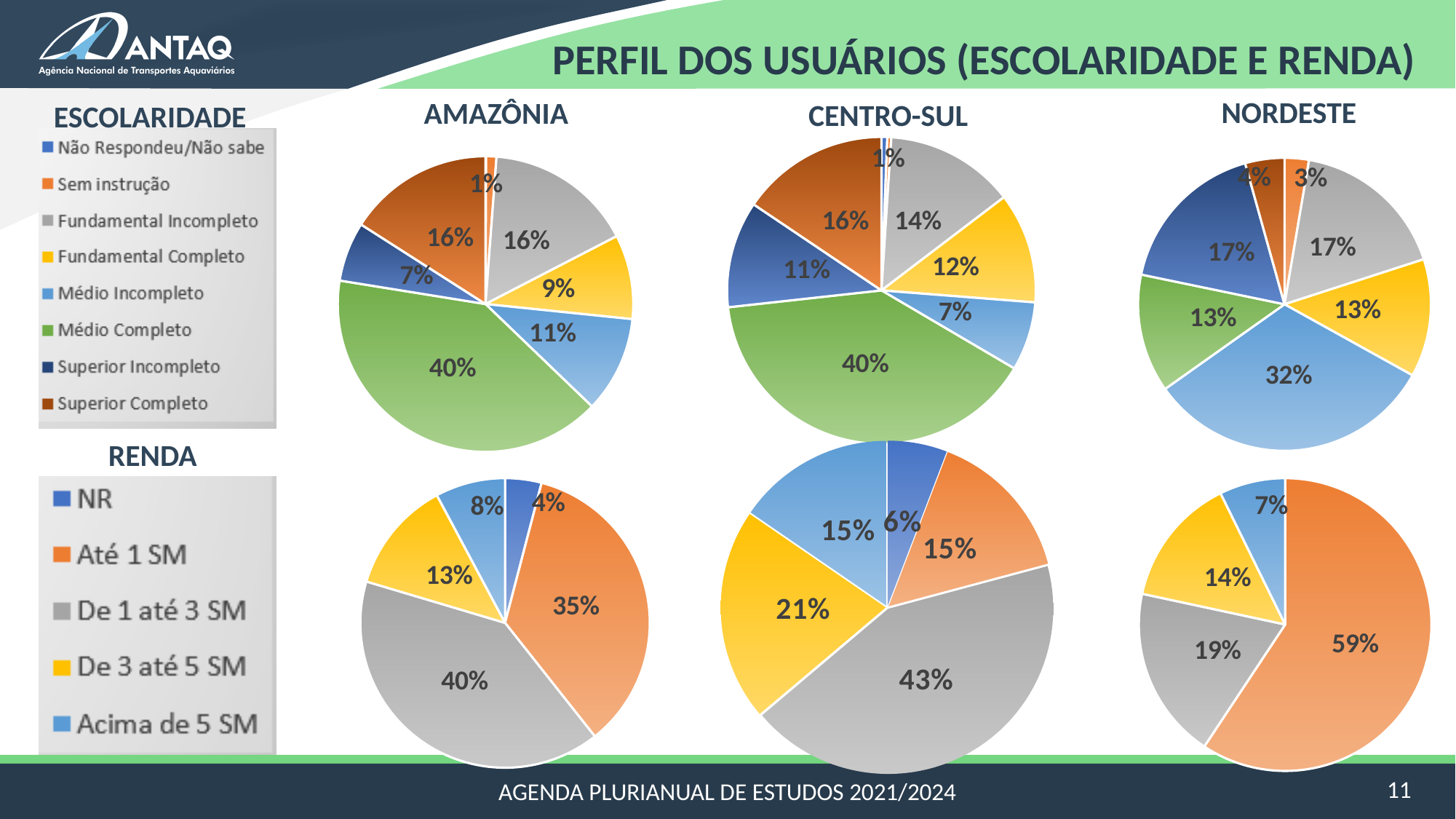
In the Nordeste Renda pie chart, what is the difference between De 1 até 3 SM and De 3 até 5 SM? 5% In the Amazônia Escolaridade pie chart, what share is Médio Completo? 40% In the Nordeste Escolaridade pie chart, what share is Médio Incompleto? 32% In the Amazônia Renda pie chart, which category has the smallest share? NR What type of chart is used for the Amazônia Renda data? Pie chart In the Centro-Sul Renda pie chart, which category has the largest share? De 1 até 3 SM How many categories does the Escolaridade legend list? 8 In the Nordeste Renda pie chart, what share is Até 1 SM? 59% In the Amazônia Renda pie chart, what is the difference between De 1 até 3 SM and Até 1 SM? 5% In the Centro-Sul Escolaridade pie chart, which is larger: Fundamental Completo or Médio Incompleto? Fundamental Completo In the Centro-Sul Escolaridade pie chart, what share is Superior Completo? 16% How many categories does the Renda legend list? 5